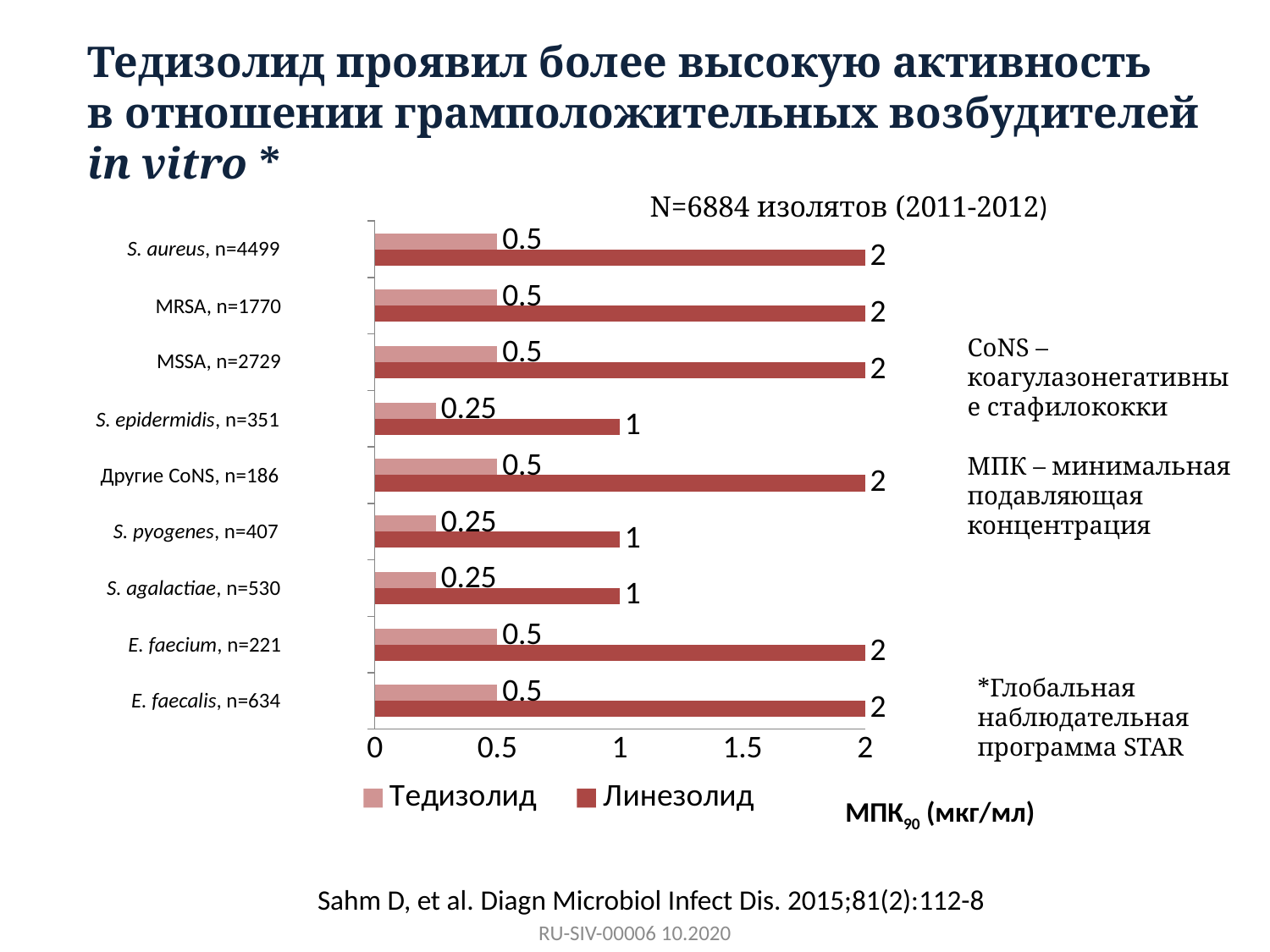
What is the x-axis label of the chart? МПК90 (мкг/мл) What is the Линезолид value for MRSA, n=1770? 2 Which series is shown in the lighter pink colour? Тедизолид What type of chart is shown on the slide? bar chart What is the Линезолид value for S. pyogenes, n=407? 1 What is the difference between the Линезолид and Тедизолид values for E. faecalis, n=634? 1.5 What is the difference between the Линезолид and Тедизолид values for S. agalactiae, n=530? 0.75 How many series does the legend list? 2 What is the Тедизолид value for S. aureus, n=4499? 0.5 For MSSA, n=2729, which series has the larger value, Тедизолид or Линезолид? Линезолид What is the Тедизолид value for S. epidermidis, n=351? 0.25 How many pathogen categories are plotted on the chart? 9